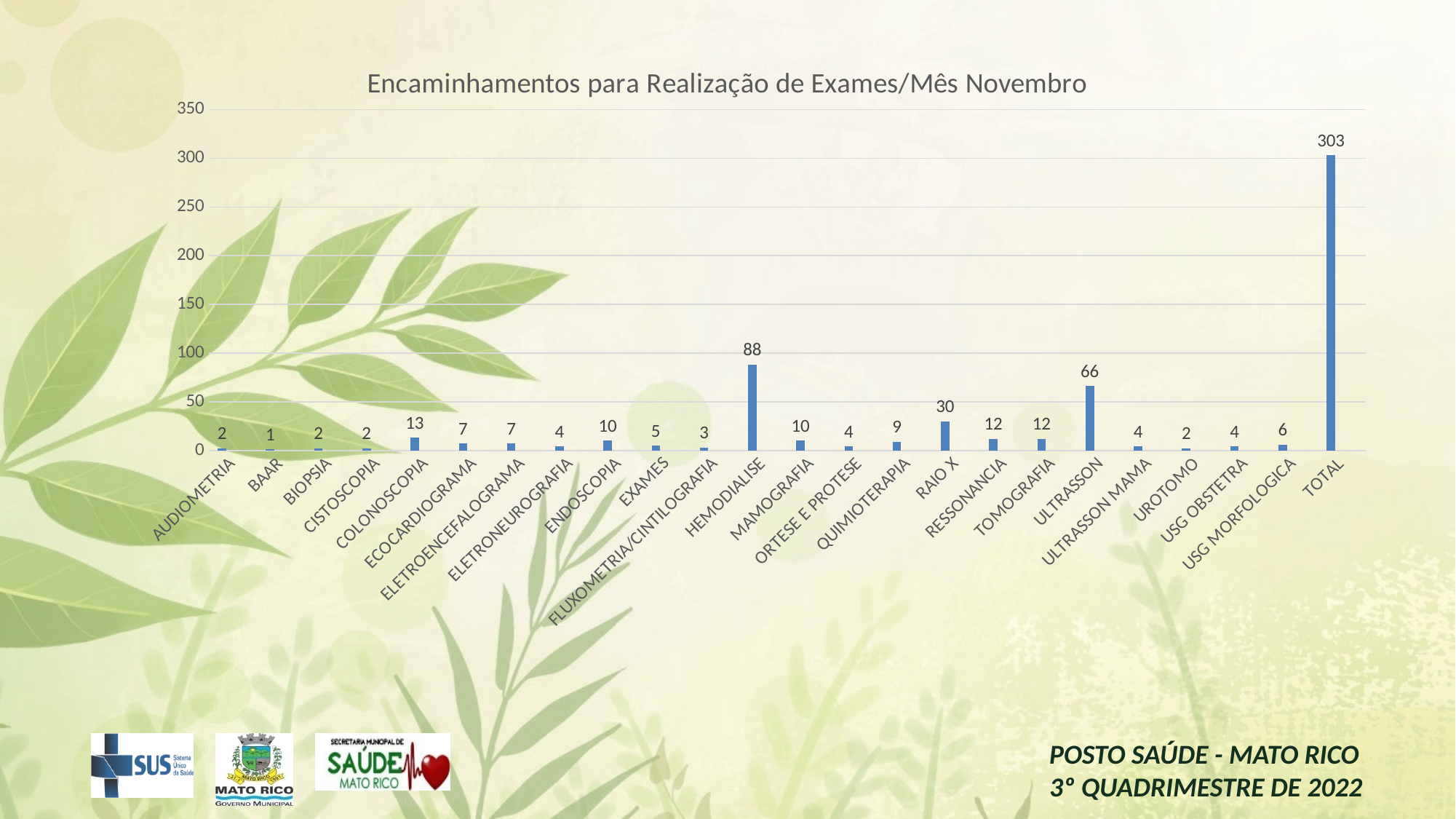
What is the difference between the values for HEMODIALISE and ULTRASSON? 22 What is the value shown for TOTAL? 303 What type of chart is shown on the slide? Bar chart Excluding the TOTAL bar, which category has the highest value? HEMODIALISE Which is larger, the value for COLONOSCOPIA or the value for ENDOSCOPIA? COLONOSCOPIA What is the title of the chart? Encaminhamentos para Realização de Exames/Mês Novembro What is the value for RAIO X? 30 What is the value for ULTRASSON? 66 Which category has the lowest value? BAAR What is the value for HEMODIALISE? 88 How many bars are plotted in the chart, including TOTAL? 24 Is the value for TOTAL greater or less than 300? greater